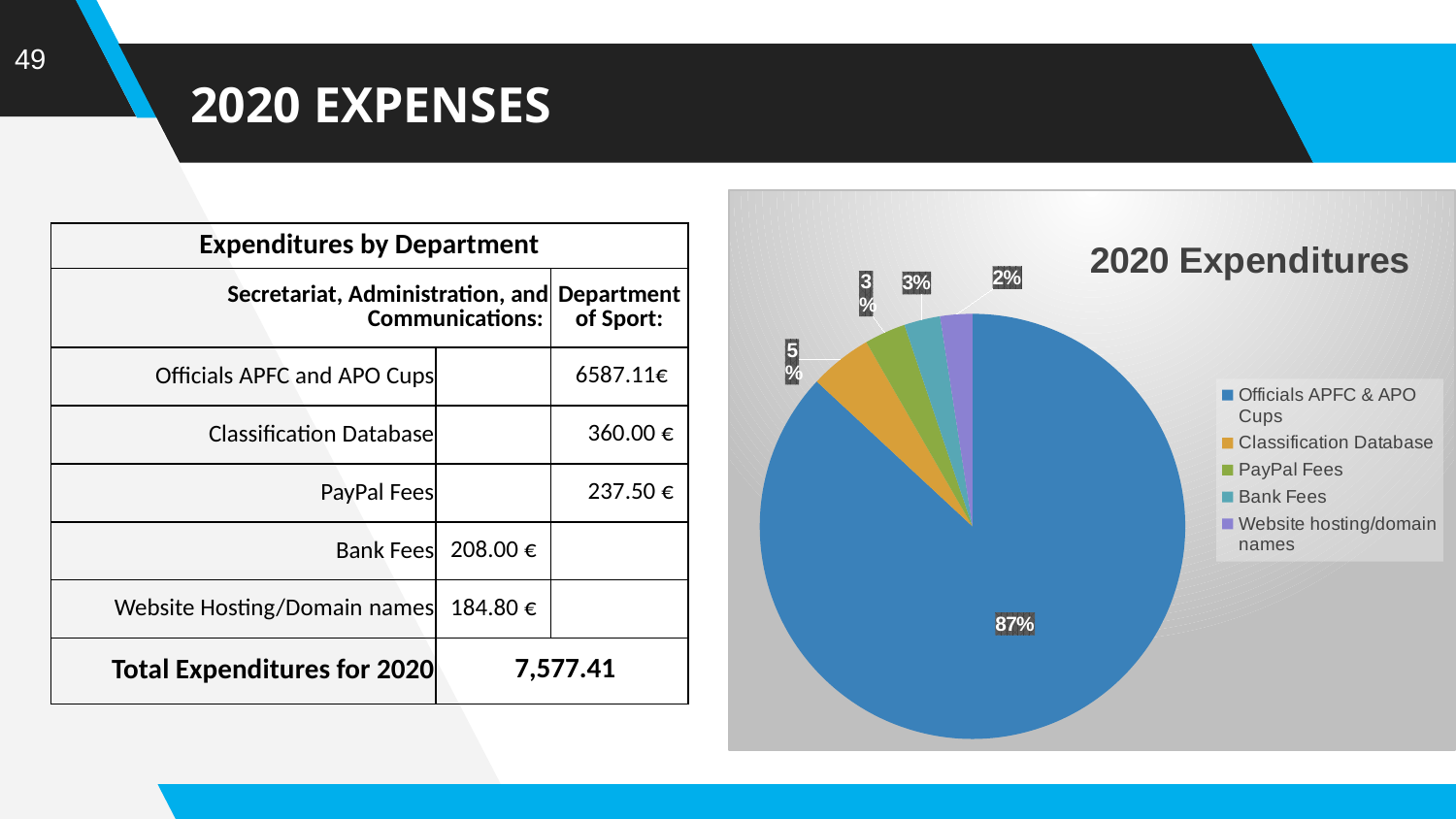
How many categories does the legend of the pie chart list? 5 Which category has the largest slice of the pie? Officials APFC & APO Cups What share of the pie does Classification Database represent? 5% What share of the pie does Officials APFC & APO Cups represent? 87% Which is larger in the pie chart, Classification Database or Website hosting/domain names? Classification Database What share of the pie does Website hosting/domain names represent? 2% What kind of chart is shown on the slide? pie chart What is the title of the chart? 2020 Expenditures Which colour represents Officials APFC & APO Cups in the pie chart? blue What is the difference in percentage points between the Officials APFC & APO Cups slice and the Classification Database slice? 82 Which category has the smallest slice of the pie? Website hosting/domain names What percentage is shown for PayPal Fees in the pie chart? 3%